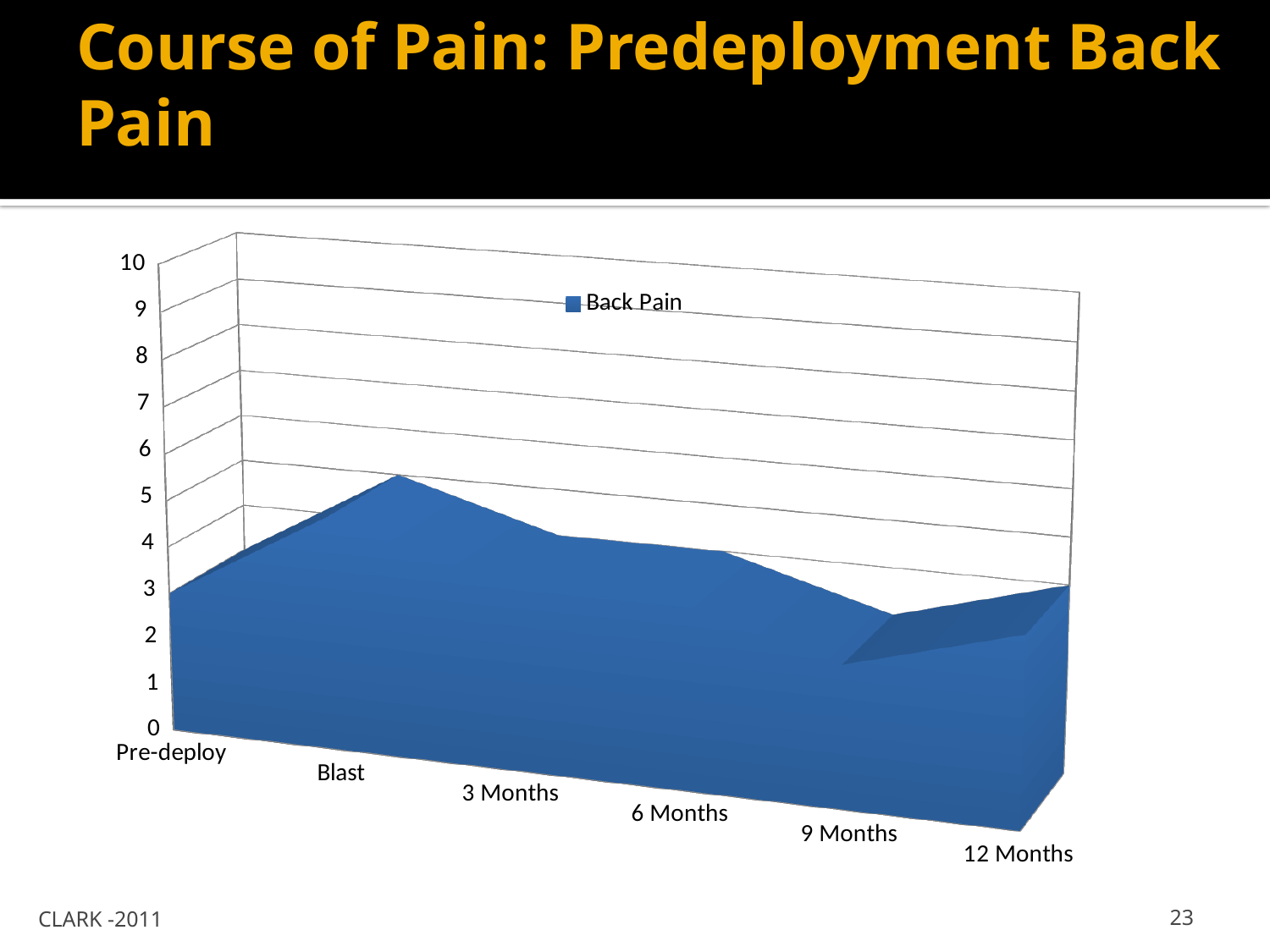
Which is larger, the Back Pain value at Blast or at Pre-deploy? Blast Is the Back Pain value at 9 Months greater or less than 5? less Is the Back Pain value at Pre-deploy greater or less than 5? less What kind of chart is shown on the slide? Area chart How many series does the legend list? 1 How many categories are plotted along the x axis? 6 Which category has the highest Back Pain value? Blast Between Blast and 9 Months, do the Back Pain values rise or fall? fall Is the Back Pain value at Blast greater or less than 4? greater Which is larger, the Back Pain value at Blast or at 9 Months? Blast What is the title of the chart slide? Course of Pain: Predeployment Back Pain What is the name of the series shown in the legend? Back Pain